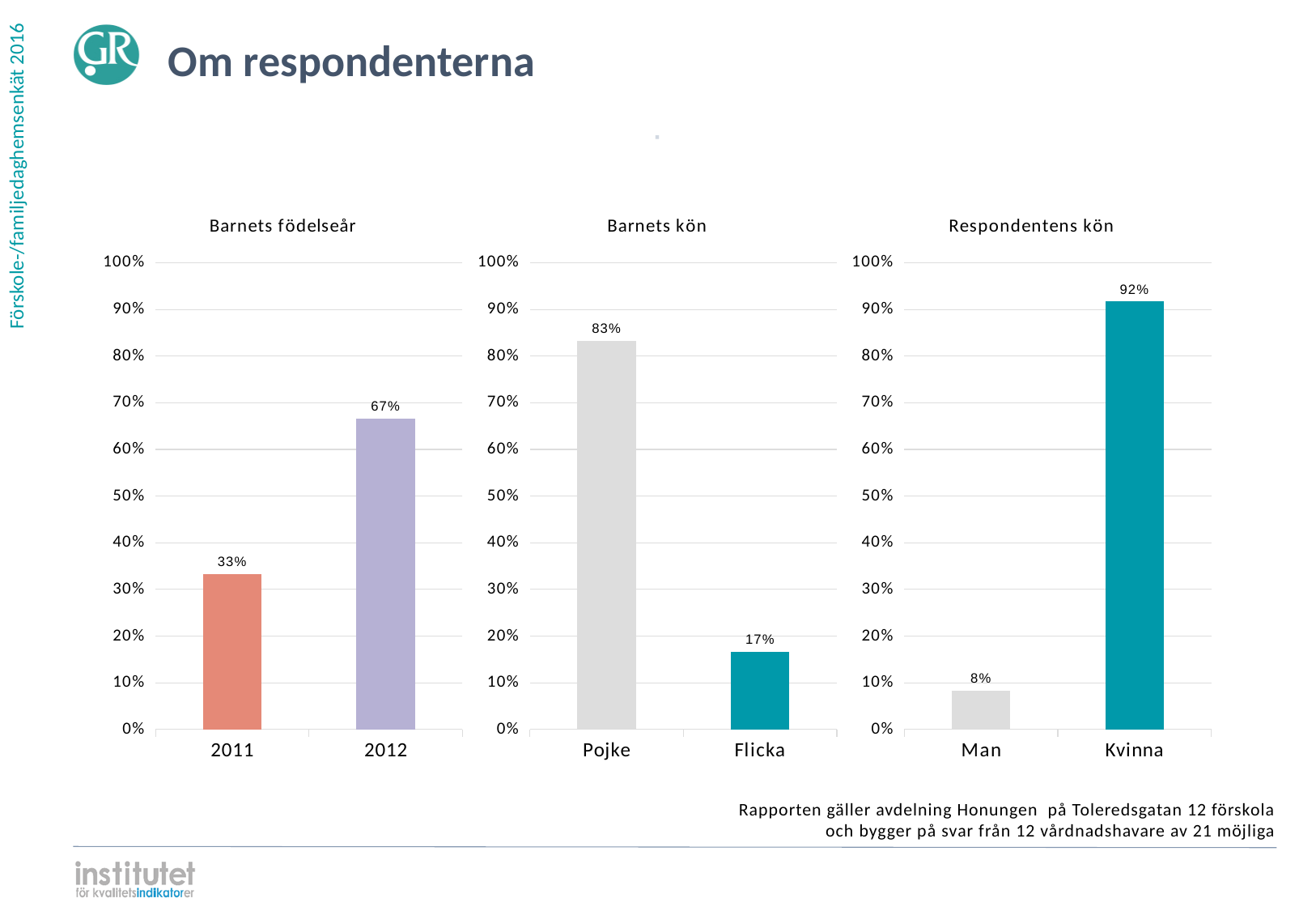
In the 'Barnets kön' chart, which category has the lowest value? Flicka In the 'Barnets kön' chart, what is the value for Flicka? 17% In the 'Barnets födelseår' chart, what is the value for 2012? 67% In the 'Barnets kön' chart, which is larger, the value for Pojke or the value for Flicka? Pojke In the 'Barnets födelseår' chart, what is the difference between the values for 2012 and 2011? 34% In the 'Barnets födelseår' chart, what is the value for 2011? 33% How many categories are shown in the 'Respondentens kön' chart? 2 In the 'Respondentens kön' chart, what is the value for Man? 8% In the 'Respondentens kön' chart, which category has the highest value? Kvinna In the 'Respondentens kön' chart, what is the value for Kvinna? 92% In the 'Barnets kön' chart, what is the value for Pojke? 83% What kind of chart is the 'Barnets födelseår' chart? Bar chart